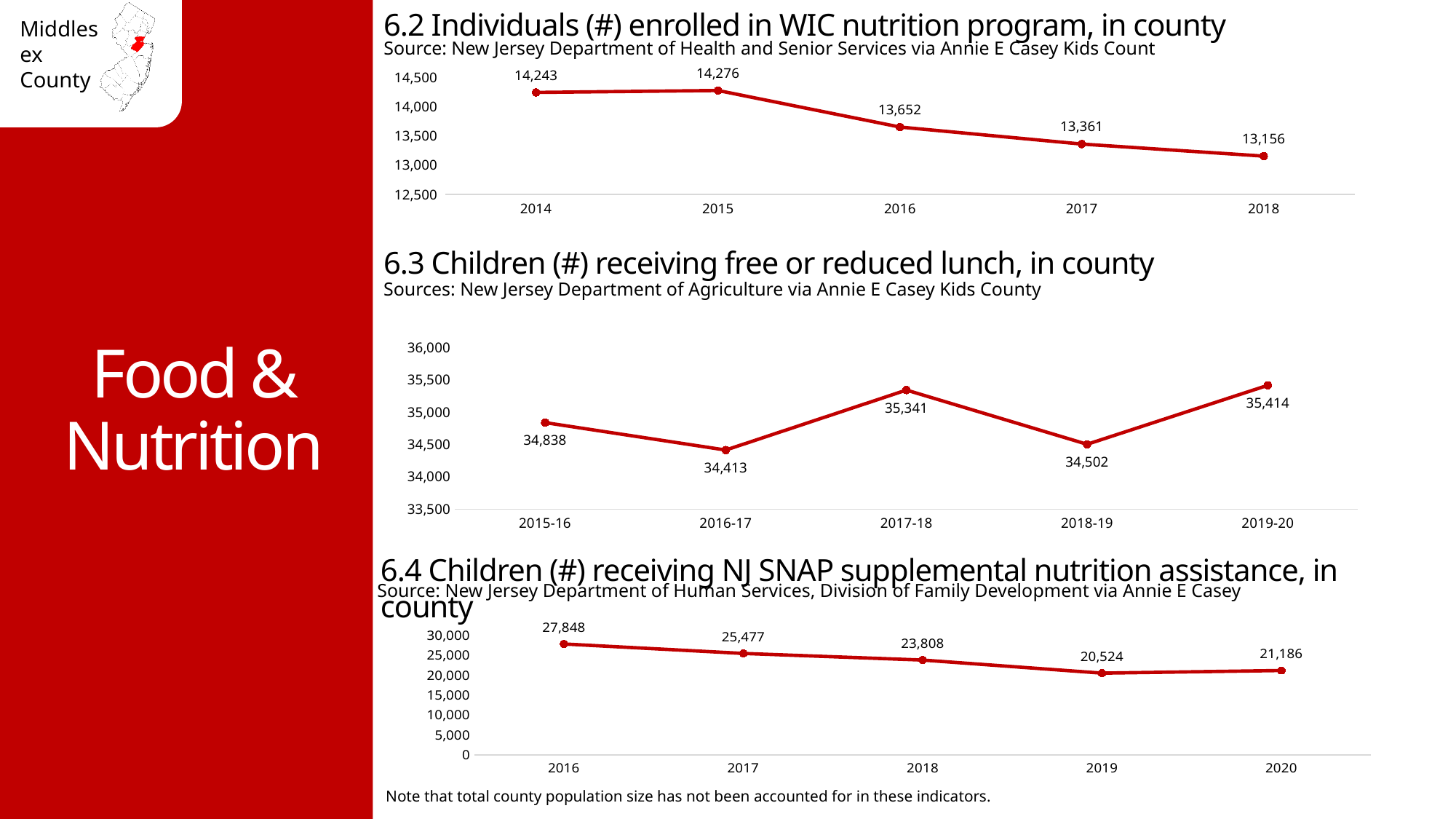
In the chart '6.2 Individuals (#) enrolled in WIC nutrition program, in county', what is the value for 2016? 13,652 In the chart '6.3 Children (#) receiving free or reduced lunch, in county', which school year has the lowest value? 2016-17 What kind of chart is '6.3 Children (#) receiving free or reduced lunch, in county'? Line chart In the chart '6.2 Individuals (#) enrolled in WIC nutrition program, in county', which year has the highest value? 2015 In the chart '6.2 Individuals (#) enrolled in WIC nutrition program, in county', what is the difference between the 2014 and 2018 values? 1,087 In the chart '6.3 Children (#) receiving free or reduced lunch, in county', which is larger, the value for 2017-18 or the value for 2019-20? 2019-20 In the chart '6.3 Children (#) receiving free or reduced lunch, in county', what is the value for 2018-19? 34,502 In the chart '6.4 Children (#) receiving NJ SNAP supplemental nutrition assistance, in county', what is the difference between the 2016 and 2018 values? 4,040 In the chart '6.4 Children (#) receiving NJ SNAP supplemental nutrition assistance, in county', what is the value for 2017? 25,477 In the chart '6.2 Individuals (#) enrolled in WIC nutrition program, in county', do the values generally rise or fall from 2015 to 2018? Fall In the chart '6.4 Children (#) receiving NJ SNAP supplemental nutrition assistance, in county', which year has the lowest value? 2019 In the chart '6.2 Individuals (#) enrolled in WIC nutrition program, in county', how many data points are plotted? 5